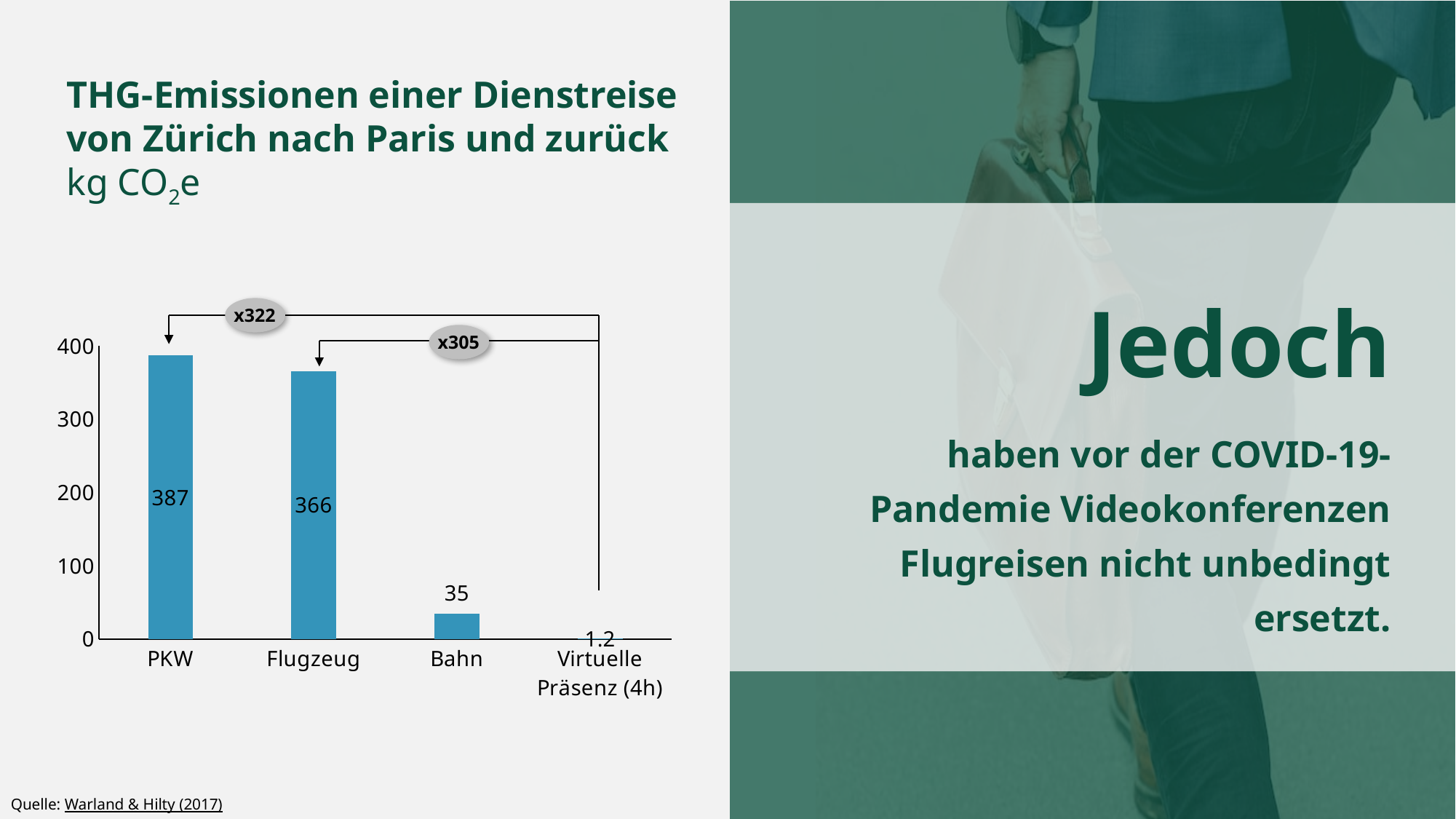
What is the difference between the values for Flugzeug and Bahn? 331 How many categories are shown on the x axis? 4 What kind of chart is this? bar chart Which category has the highest value? PKW What is the value for PKW? 387 Which is larger, the value for Bahn or the value for Virtuelle Präsenz (4h)? Bahn What is the value for Virtuelle Präsenz (4h)? 1.2 What is the value for Flugzeug? 366 What is the value for Bahn? 35 Which category has the lowest value? Virtuelle Präsenz (4h) What is the difference between the values for PKW and Flugzeug? 21 What unit is given below the chart title? kg CO2e